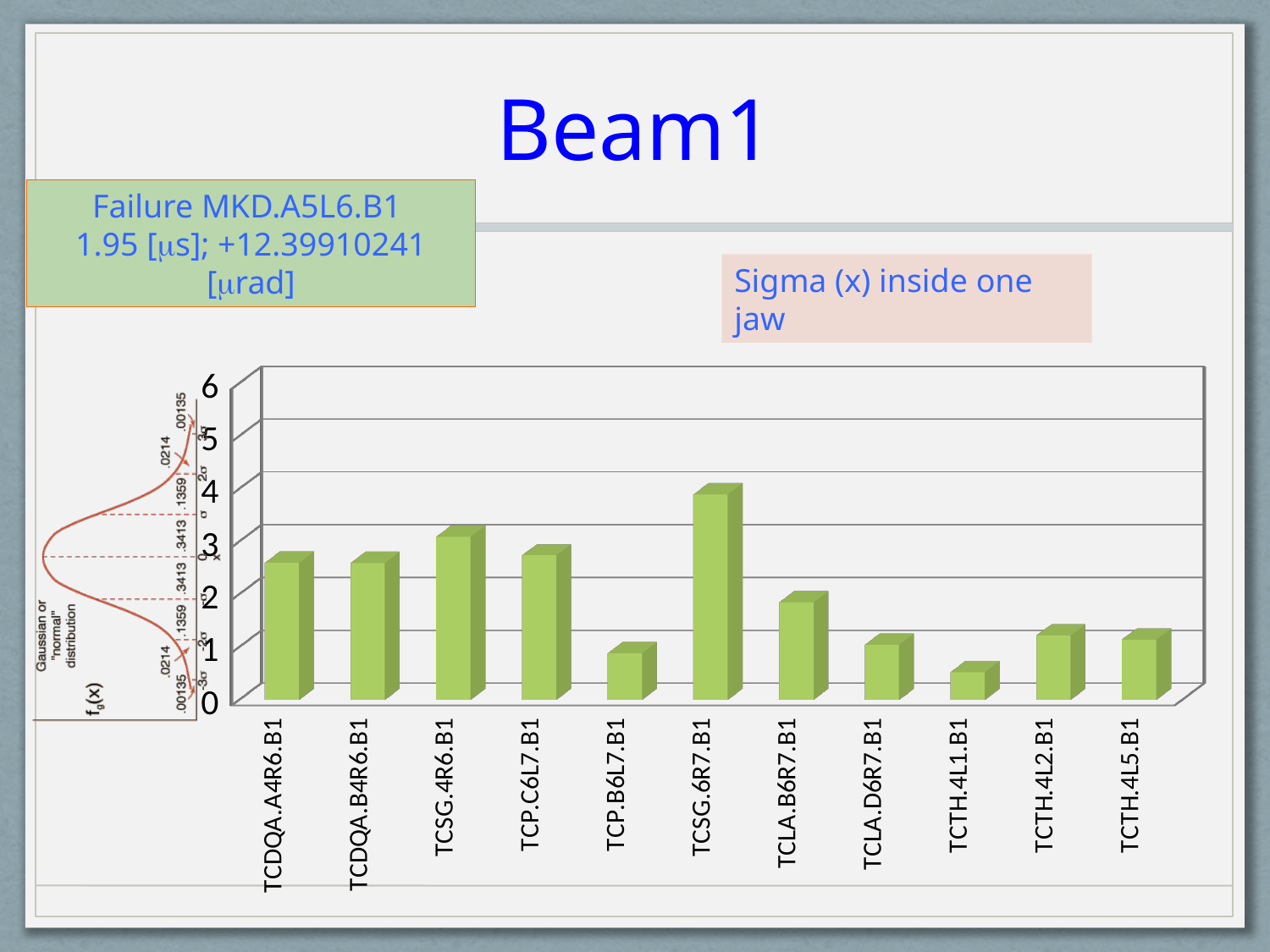
Is the value for TCP.B6L7.B1 greater or less than 2? less What kind of chart is shown on the slide? bar chart Which collimator has the lowest bar in the chart? TCTH.4L1.B1 How many collimators (categories) are plotted on the x axis of the chart? 11 Is the value for TCSG.6R7.B1 greater or less than 3? greater Which is larger, the value for TCP.C6L7.B1 or the value for TCP.B6L7.B1? TCP.C6L7.B1 Is the value for TCLA.B6R7.B1 greater or less than 1? greater What is the title of the slide containing the chart? Beam1 Which is larger, the value for TCSG.6R7.B1 or the value for TCLA.B6R7.B1? TCSG.6R7.B1 Which collimator has the highest bar in the chart? TCSG.6R7.B1